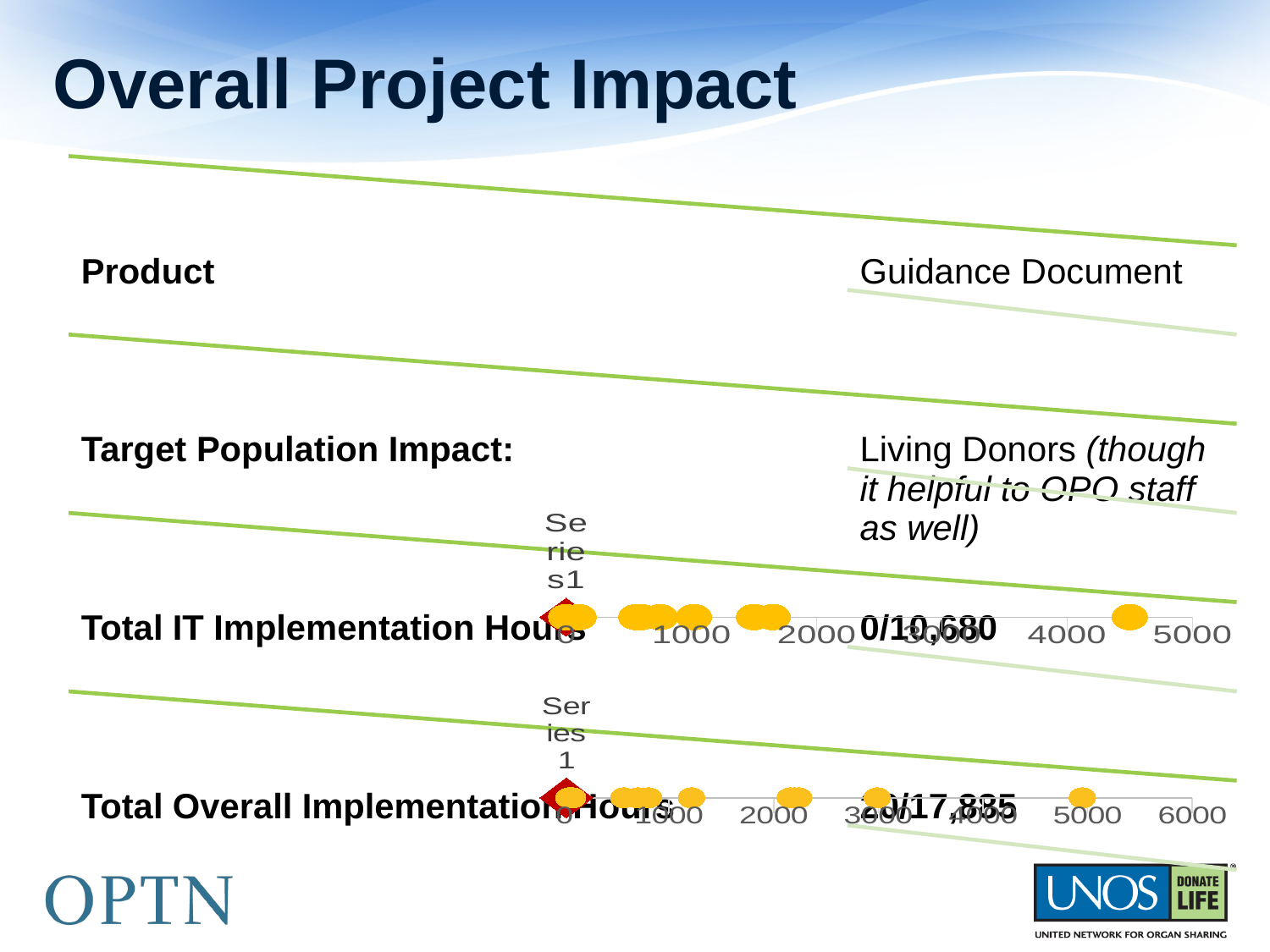
On the upper chart (next to Total IT Implementation Hours), what is the highest value shown on the x axis? 5000 On the lower chart (next to Total Overall Implementation Hours), is the rightmost plotted point greater or less than 6000 on the x axis? less On the lower chart (next to Total Overall Implementation Hours), what is the highest value shown on the x axis? 6000 On the upper chart (next to Total IT Implementation Hours), is the rightmost plotted point greater or less than 4000 on the x axis? greater On the lower chart (next to Total Overall Implementation Hours), is the rightmost plotted point greater or less than 4000 on the x axis? greater